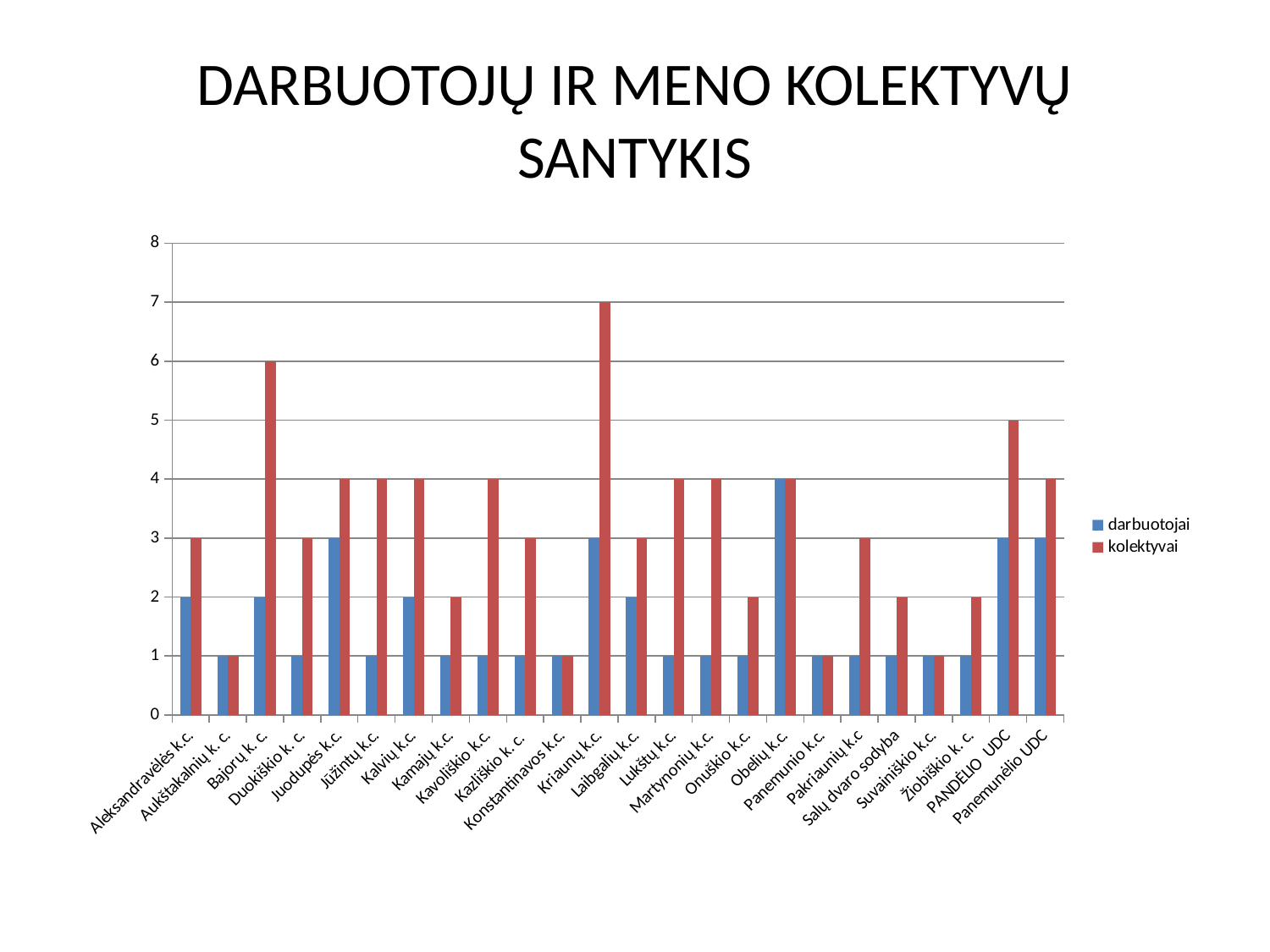
Is the kolektyvai value for Kriaunų k.c. greater or less than 6? greater How many series does the legend list? 2 Which category has the highest kolektyvai value? Kriaunų k.c. Which is larger for Kalvių k.c., darbuotojai or kolektyvai? kolektyvai What is the difference between the kolektyvai and darbuotojai values for Kriaunų k.c.? 4 How many categories are shown on the x axis? 24 What is the kolektyvai value for PANDĖLIO UDC? 5 What is the title of the chart? DARBUOTOJŲ IR MENO KOLEKTYVŲ SANTYKIS What kind of chart is shown on the slide? bar chart Which category has the highest darbuotojai value? Obelių k.c. What is the kolektyvai value for Bajorų k. c.? 6 What is the darbuotojai value for Juodupės k.c.? 3